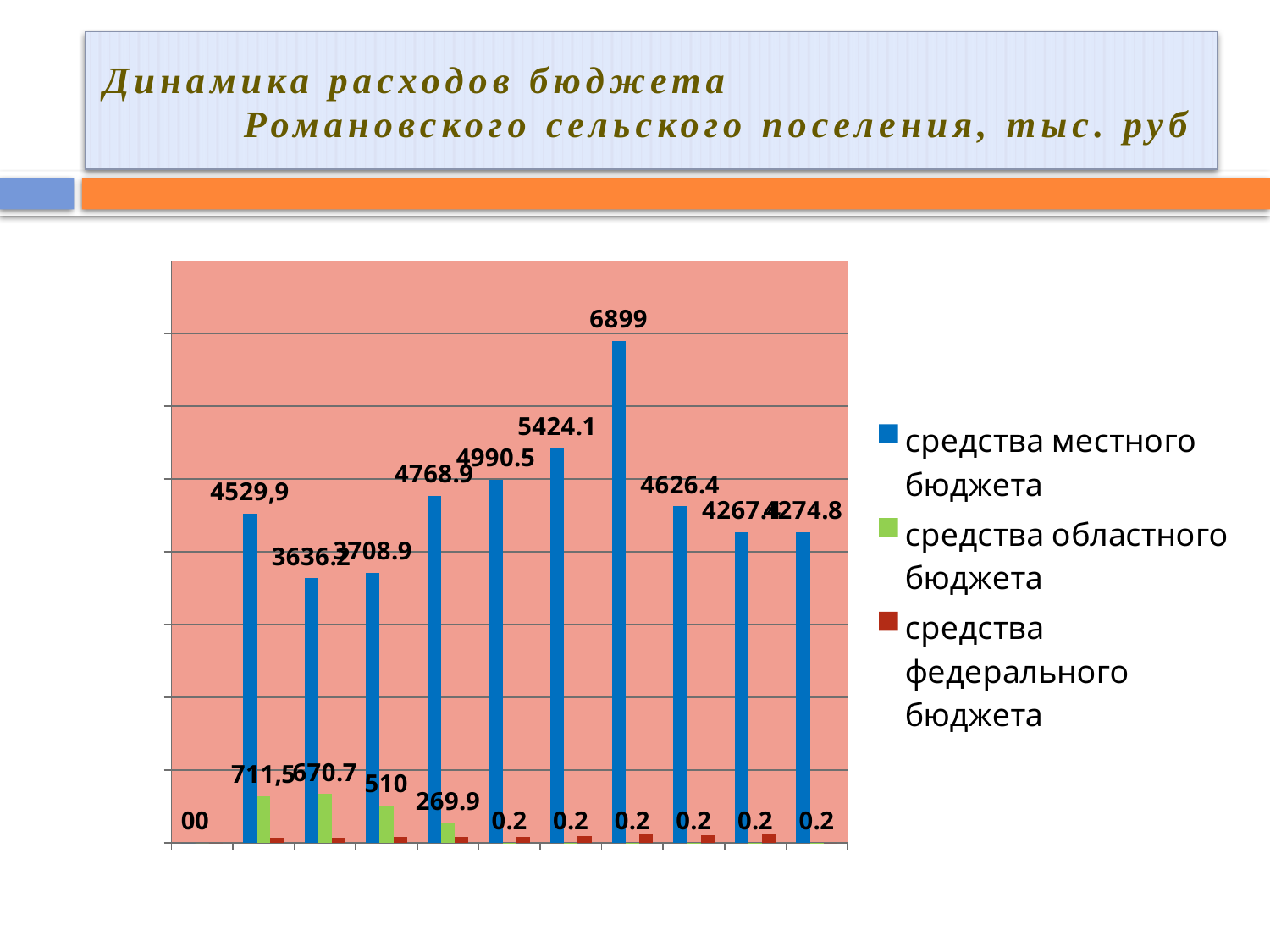
What is the title of the slide? Динамика расходов бюджета Романовского сельского поселения, тыс. руб What is the difference between the highest and lowest labelled values of the series 'средства местного бюджета'? 3262.8 Do the values of 'средства местного бюджета' rise steadily from left to right across the chart? No What is the highest value labelled for the series 'средства областного бюджета'? 711,5 Which is larger for 'средства местного бюджета': the bar labelled 5424.1 or the bar labelled 4990.5? 5424.1 What is the lowest value labelled for the series 'средства местного бюджета'? 3636.2 What kind of chart is shown on the slide? bar chart How many bars of the series 'средства местного бюджета' are plotted? 10 How many series does the legend list? 3 What is the highest value labelled for the series 'средства местного бюджета'? 6899 What is the difference between the 'средства областного бюджета' values 711,5 and 670.7? 40.8 Which series is shown in green in the legend? средства областного бюджета